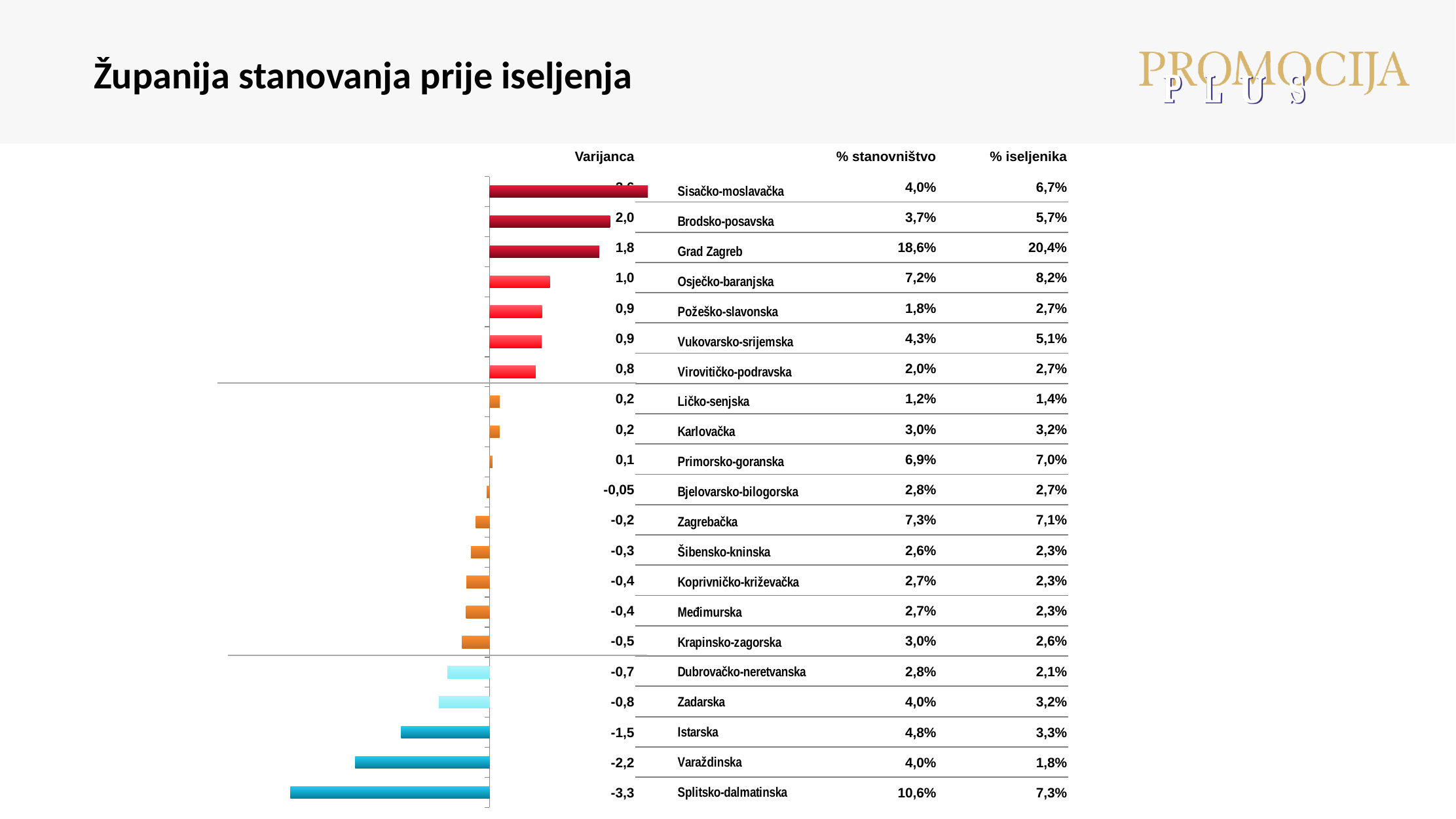
What is the difference between the Varijanca values of Istarska and Varaždinska? 0,7 What is the Varijanca value for Krapinsko-zagorska? -0,5 What is the Varijanca value for Grad Zagreb? 1,8 What is the difference between the Varijanca values of Brodsko-posavska and Grad Zagreb? 0,2 What is the Varijanca value for Splitsko-dalmatinska? -3,3 Which county has the lowest Varijanca value? Splitsko-dalmatinska Which county has the highest Varijanca value? Sisačko-moslavačka What is the Varijanca value for Bjelovarsko-bilogorska? -0,05 What colour are the bars for the counties with the most negative Varijanca values, such as Splitsko-dalmatinska and Varaždinska? blue What kind of chart is shown on the slide? bar chart How many counties are plotted in the chart? 21 Which has the larger Varijanca value, Osječko-baranjska or Virovitičko-podravska? Osječko-baranjska